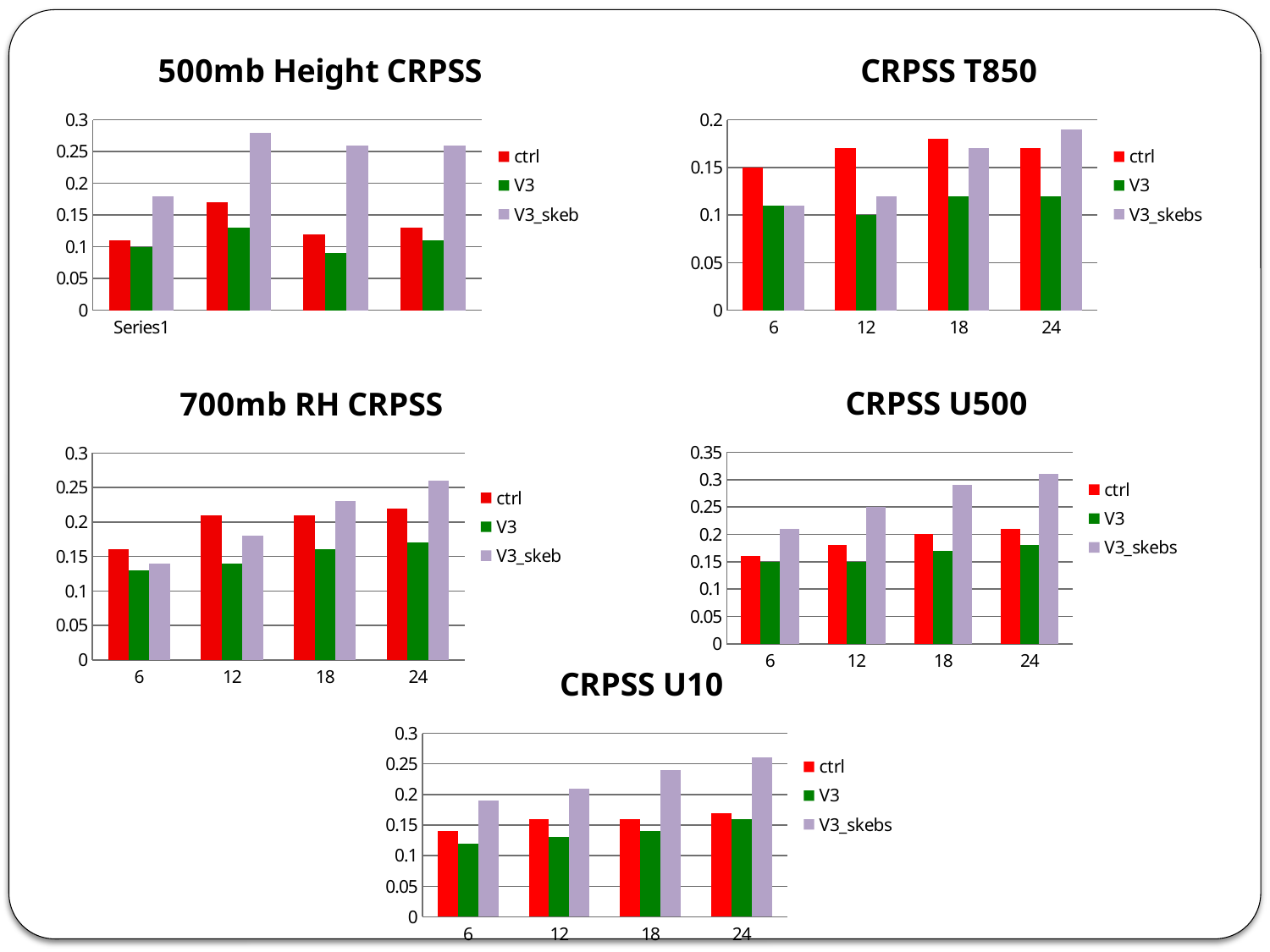
In the "CRPSS U10" chart, at 6, which is larger: ctrl or V3_skebs? V3_skebs What are the legend entries in the "700mb RH CRPSS" chart? ctrl, V3, V3_skeb What kind of chart is the "500mb Height CRPSS" chart? bar chart In the "CRPSS U500" chart, how many categories are shown on the x axis? 4 What is the only category label shown on the x axis of the "500mb Height CRPSS" chart? Series1 In the "700mb RH CRPSS" chart, is the V3_skeb value at 24 greater or less than 0.2? greater In the "CRPSS U10" chart, do the V3_skebs values rise or fall from 6 to 24? rise In the "CRPSS U500" chart, is the V3_skebs value at 24 greater or less than 0.25? greater In the "700mb RH CRPSS" chart, which series has the lowest value at 12? V3 In the "CRPSS T850" chart, how many series does the legend list? 3 In the "CRPSS U10" chart, which series has the highest value at 24? V3_skebs In the "CRPSS T850" chart, is the ctrl value at 6 greater or less than 0.1? greater